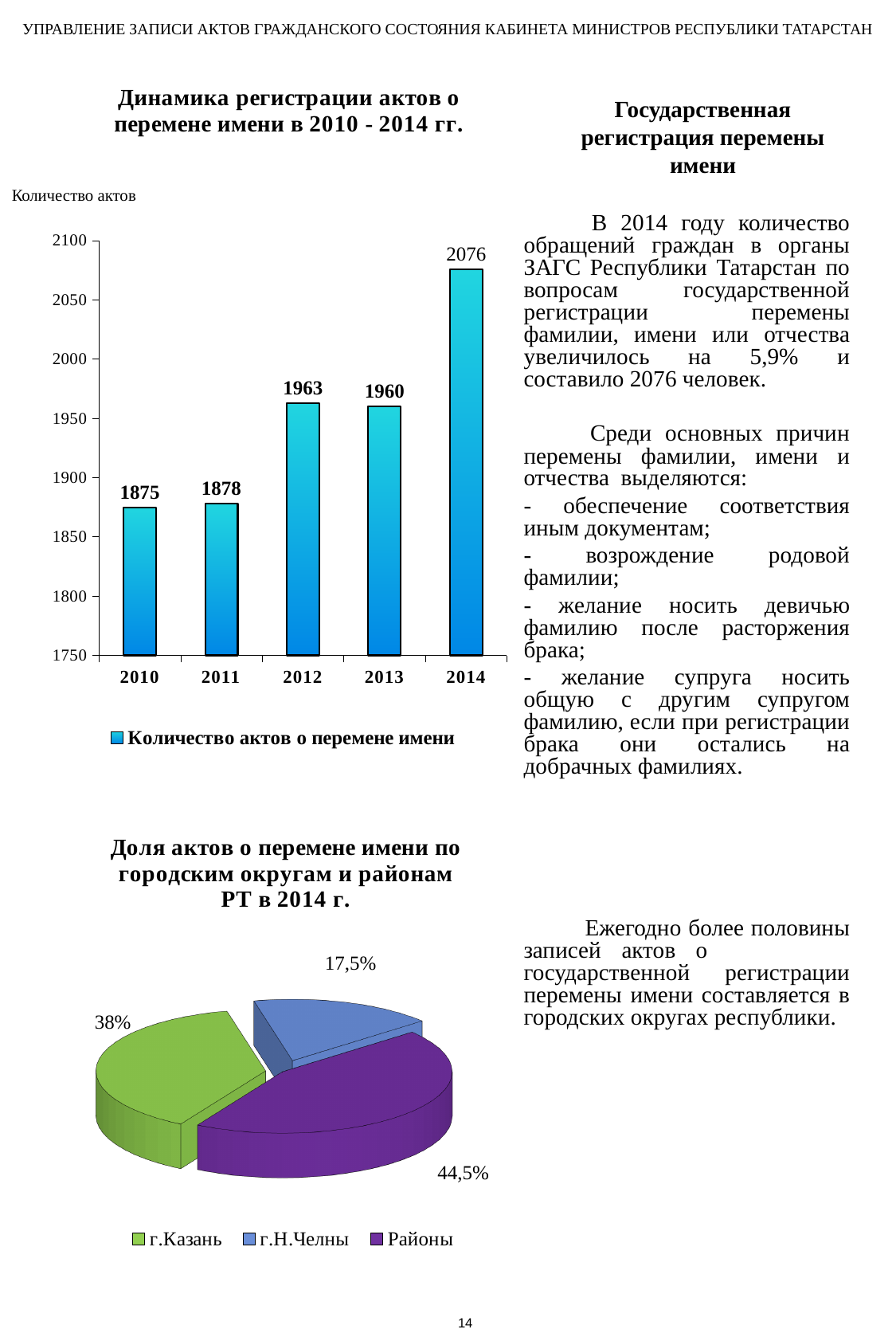
In the chart 'Доля актов о перемене имени по городским округам и районам РТ в 2014 г.', what is the share for Районы? 44,5% In the chart 'Динамика регистрации актов о перемене имени в 2010 - 2014 гг.', how many years are shown on the x axis? 5 How many categories does the legend of the chart 'Доля актов о перемене имени по городским округам и районам РТ в 2014 г.' list? 3 In the chart 'Динамика регистрации актов о перемене имени в 2010 - 2014 гг.', which year has the lowest value? 2010 In the chart 'Доля актов о перемене имени по городским округам и районам РТ в 2014 г.', what is the share for г.Н.Челны? 17,5% In the chart 'Динамика регистрации актов о перемене имени в 2010 - 2014 гг.', what is the difference between the values for 2014 and 2013? 116 In the chart 'Доля актов о перемене имени по городским округам и районам РТ в 2014 г.', which category has the smallest slice? г.Н.Челны In the chart 'Динамика регистрации актов о перемене имени в 2010 - 2014 гг.', which year has the highest value? 2014 In the chart 'Динамика регистрации актов о перемене имени в 2010 - 2014 гг.', what is the value for 2014? 2076 In the chart 'Динамика регистрации актов о перемене имени в 2010 - 2014 гг.', what is the value for 2010? 1875 In the chart 'Динамика регистрации актов о перемене имени в 2010 - 2014 гг.', which is larger, the value for 2012 or the value for 2011? 2012 What kind of chart is 'Динамика регистрации актов о перемене имени в 2010 - 2014 гг.'? bar chart